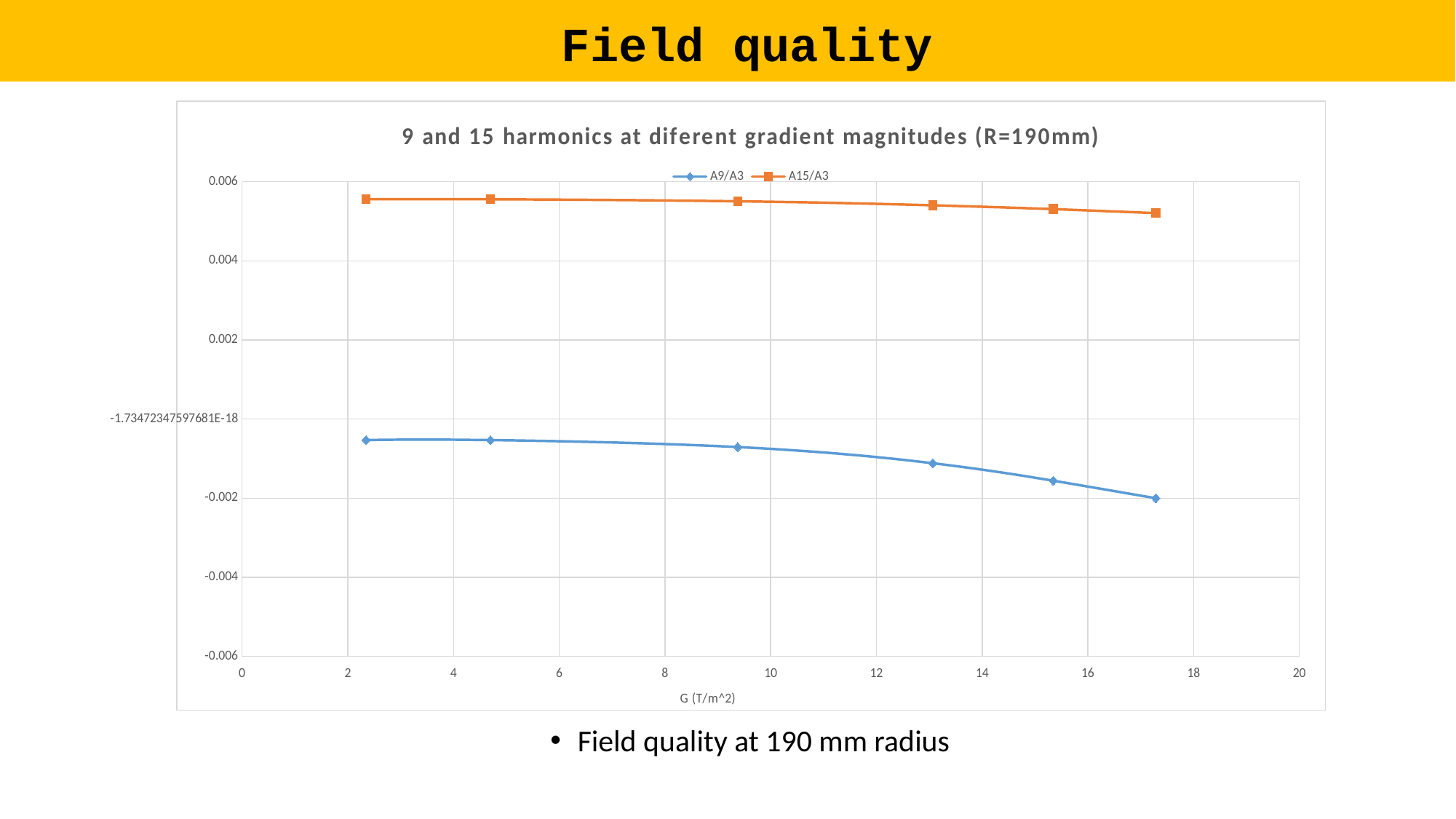
What is the title of the chart? 9 and 15 harmonics at diferent gradient magnitudes (R=190mm) What kind of chart is shown on the slide? line chart Is the value of A15/A3 at the first plotted point greater or less than 0.004? greater Is the value of A9/A3 at G of about 13 greater or less than 0.002? less How many data points are plotted for the A9/A3 series? 6 Is the value of A9/A3 at the first plotted point greater or less than -0.002? greater What is the label of the x axis? G (T/m^2) Does the A15/A3 series rise or fall as G increases along the x axis? fall Does the A9/A3 series rise or fall as G increases along the x axis? fall How many series does the legend list? 2 Which series has the higher values across the chart, A9/A3 or A15/A3? A15/A3